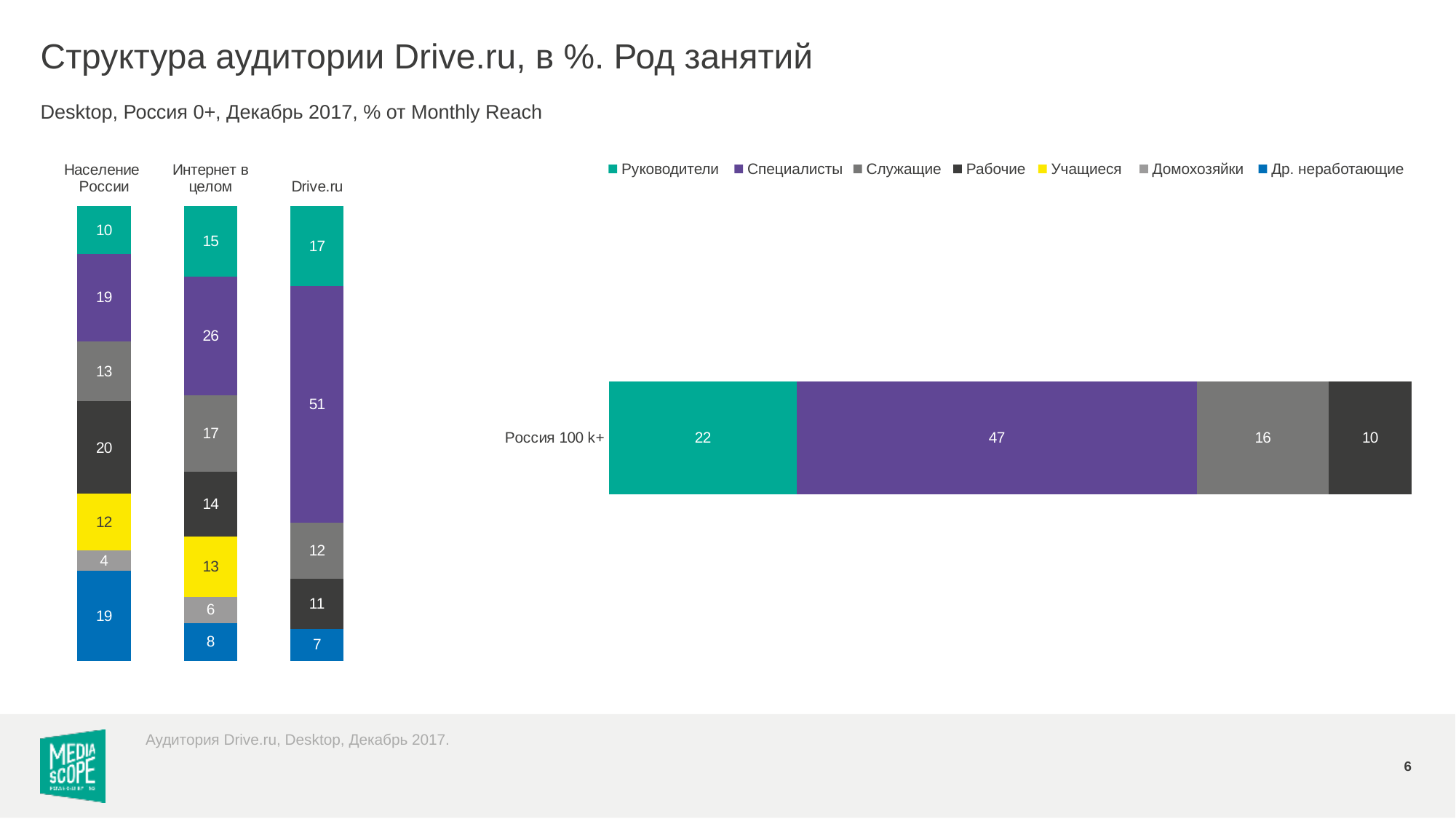
In the left chart, what is the value for Рабочие in the Население России bar? 20 In the left chart, which segment of the Население России bar is the smallest? Домохозяйки In the left chart, what is the value for Специалисты in the Drive.ru bar? 51 How many series does the legend list? 7 In the left chart, what is the value for Учащиеся in the Интернет в целом bar? 13 In the left chart, which is larger: Руководители for Drive.ru or Руководители for Население России? Drive.ru How many bars does the left chart show? 3 In the left chart, what is the difference between the Специалисты values for Drive.ru and Интернет в целом? 25 In the right chart, what is the total of the Россия 100 k+ bar? 95 In the right chart, which segment of the Россия 100 k+ bar is the largest? Специалисты In the right chart, what is the value for Руководители for Россия 100 k+? 22 What kind of chart is the right chart? Stacked bar chart